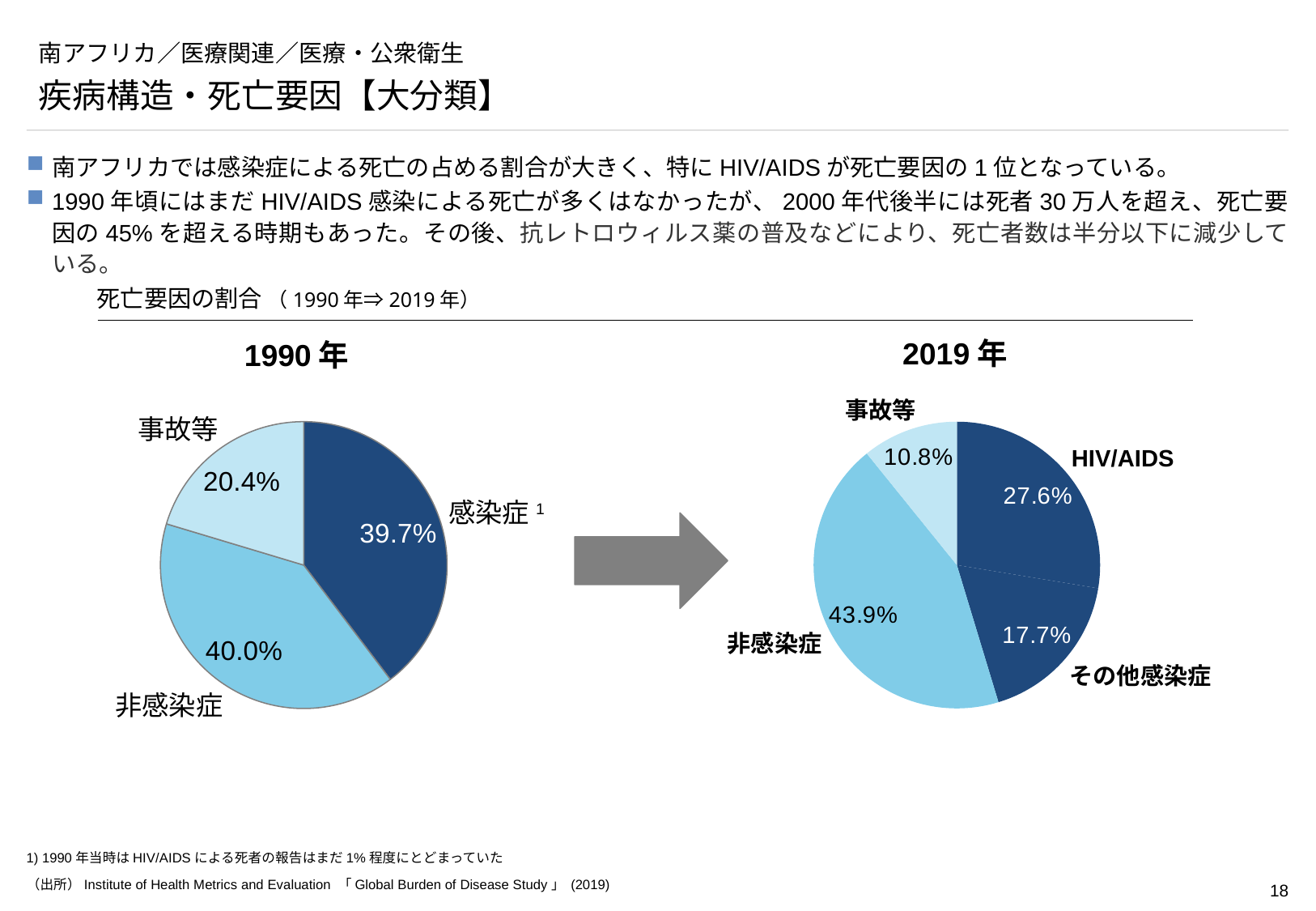
In the 2019年 pie chart, which category has the largest share? 非感染症 In the 1990年 pie chart, how many slices are there? 3 In the 2019年 pie chart, what share is labelled for その他感染症? 17.7% In the 2019年 pie chart, which is larger, the share of 非感染症 or the share of HIV/AIDS? 非感染症 In the 1990年 pie chart, which category has the smallest share? 事故等 In the 2019年 pie chart, how many slices are there? 4 In the 2019年 pie chart, what is the difference between the shares of HIV/AIDS and その他感染症? 9.9% In the 2019年 pie chart, what share is labelled for HIV/AIDS? 27.6% In the 2019年 pie chart, which category has the smallest share? 事故等 In the 1990年 pie chart, what share is labelled for 感染症? 39.7% What kind of charts are shown on the slide? Pie charts In the 1990年 pie chart, what share is labelled for 事故等? 20.4%